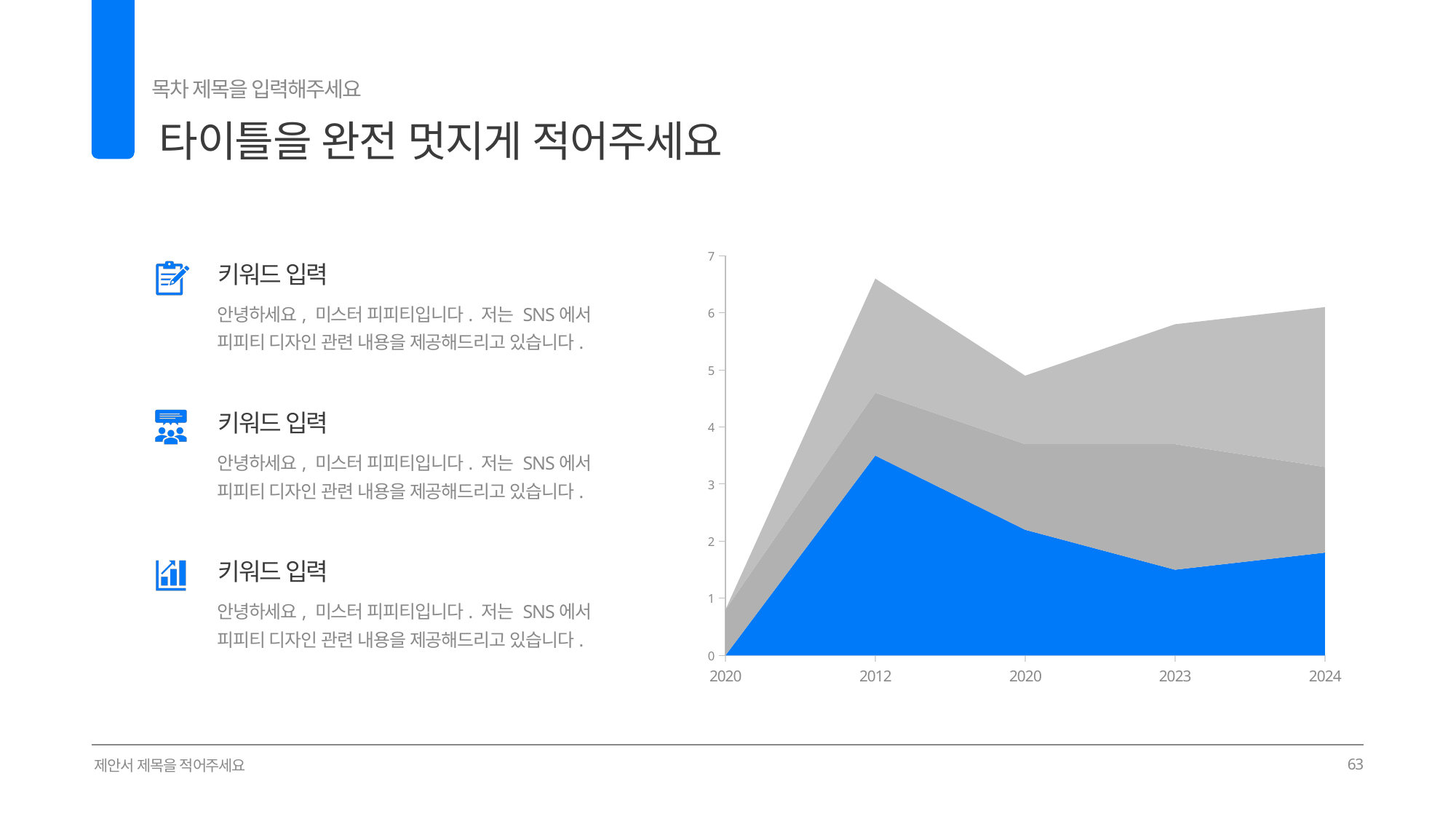
Which is larger for the blue (bottom) series: the value at 2012 or the value at 2024? 2012 Is the value of the blue (bottom) series at 2012 greater or less than 3? greater What is the highest tick value shown on the y axis? 7 What kind of chart is shown on the slide? area chart Is the value of the blue (bottom) series at 2023 greater or less than 2? less How many stacked series are plotted in the chart? 3 Does the blue (bottom) series rise or fall from 2012 to 2023? fall Is the top of the stacked areas at 2012 greater or less than 6? greater Which is larger for the total stacked height: 2012 or 2023? 2012 How many categories are shown on the x axis of the chart? 5 At which x-axis category does the blue (bottom) series reach its highest value? 2012 What colour is the bottom series of the stacked area chart? blue